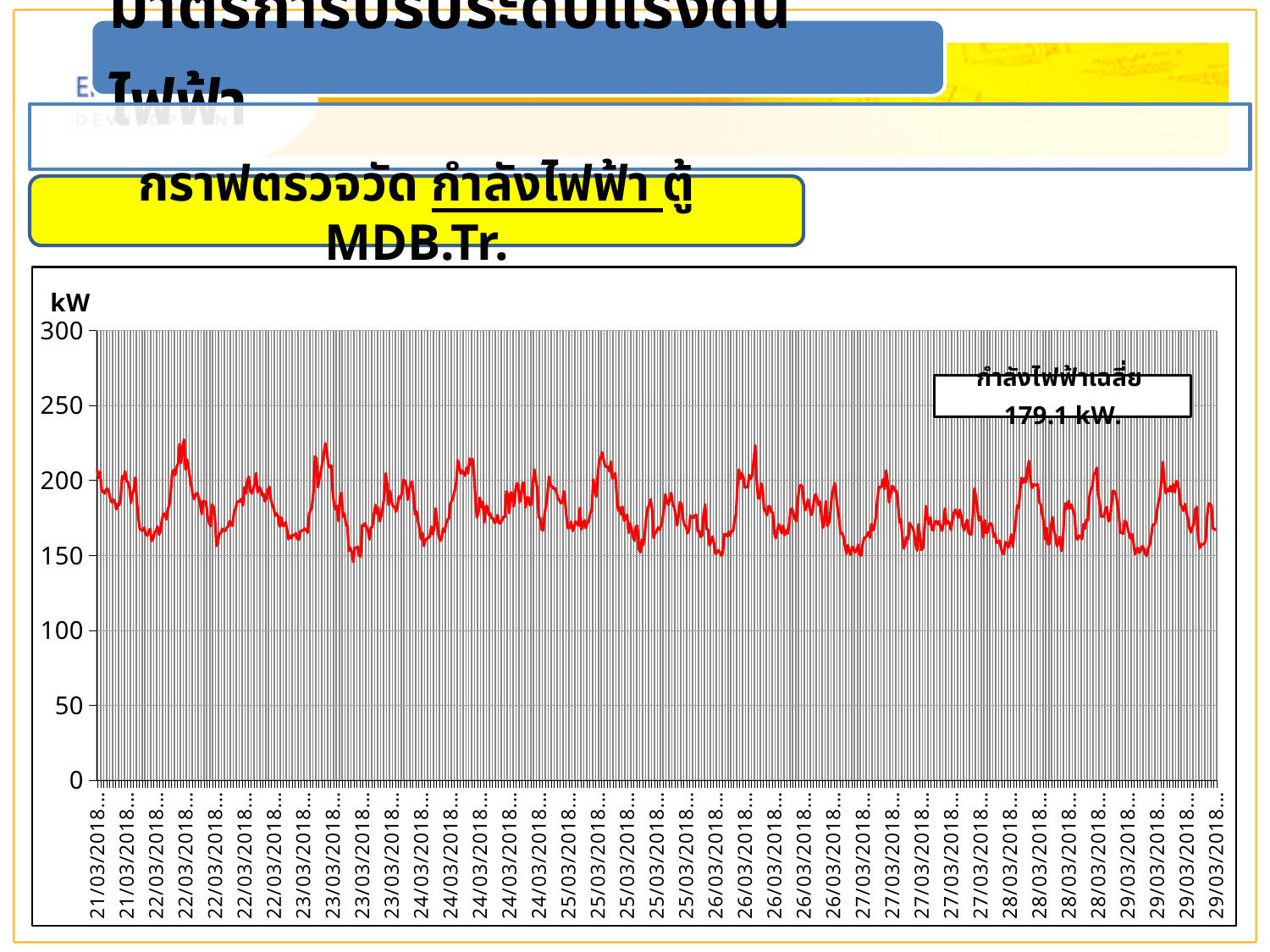
What unit is shown on the vertical axis of the chart? kW What average power value is printed in the annotation box on the chart? 179.1 kW How many data series are plotted on the chart? 1 Is the highest point of the plotted line greater or less than 250 kW? less Is the lowest point of the plotted line greater or less than 100 kW? greater Is the peak value reached on 22/03/2018 greater or less than 200 kW? greater What is the last date shown on the horizontal axis? 29/03/2018 What kind of chart is shown on the slide? line chart What is the first date shown on the horizontal axis? 21/03/2018 What is the highest tick value shown on the vertical axis? 300